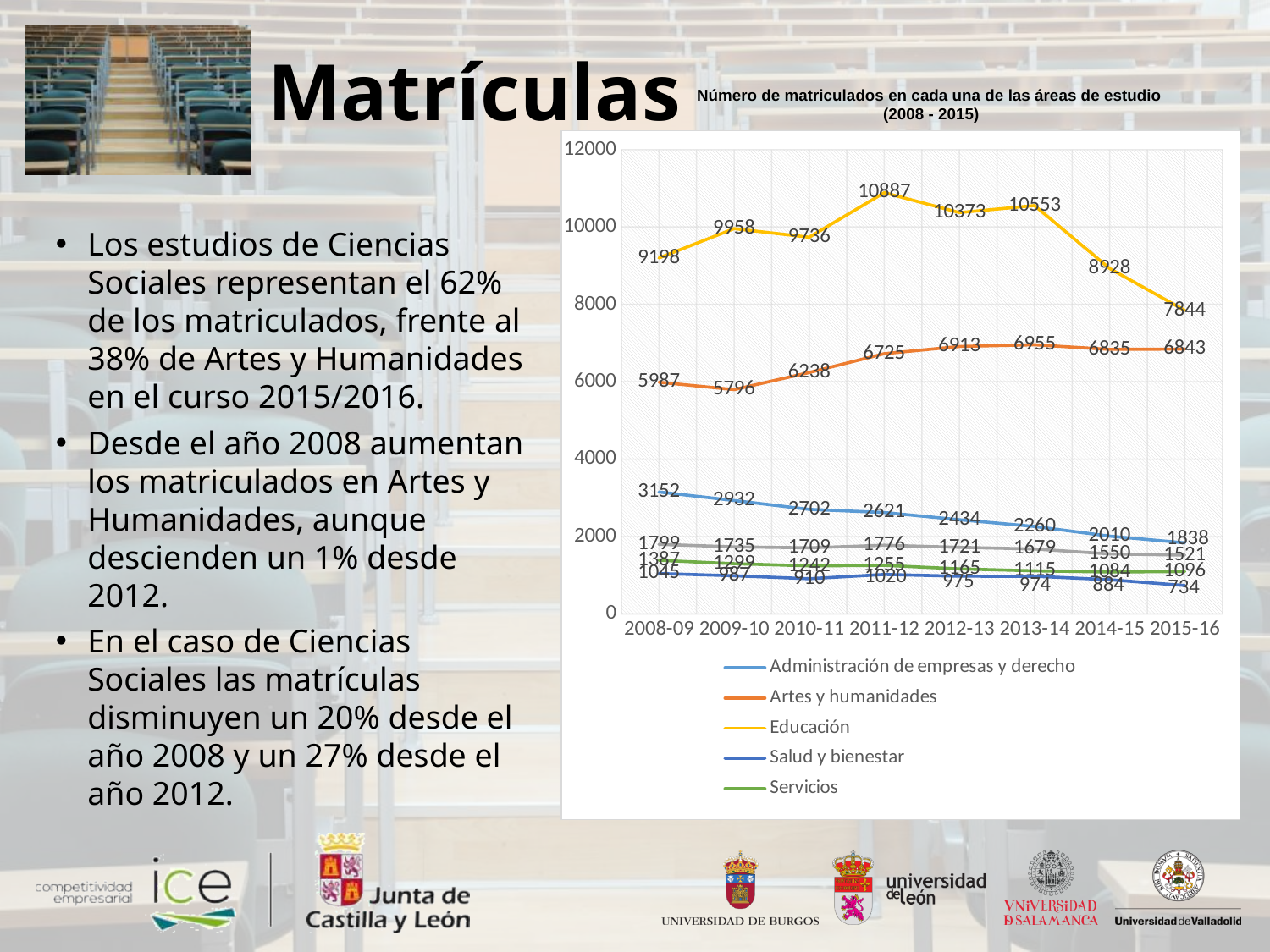
What type of chart is shown on the slide? Line chart What is the difference between the Educación values in 2013-14 and 2015-16? 2709 What is the title of the chart? Número de matriculados en cada una de las áreas de estudio (2008 - 2015) What is the value for Artes y humanidades in 2015-16? 6843 Which series has the higher value in 2015-16, Educación or Artes y humanidades? Educación What is the value for Educación in 2011-12? 10887 Does the value for Administración de empresas y derecho rise or fall from 2008-09 to 2015-16? Fall In which academic year does Educación have its lowest value? 2015-16 What is the value for Administración de empresas y derecho in 2008-09? 3152 How many series does the chart legend list? 5 How many academic years are shown on the x axis of the chart? 8 In which academic year does Educación reach its highest value? 2011-12